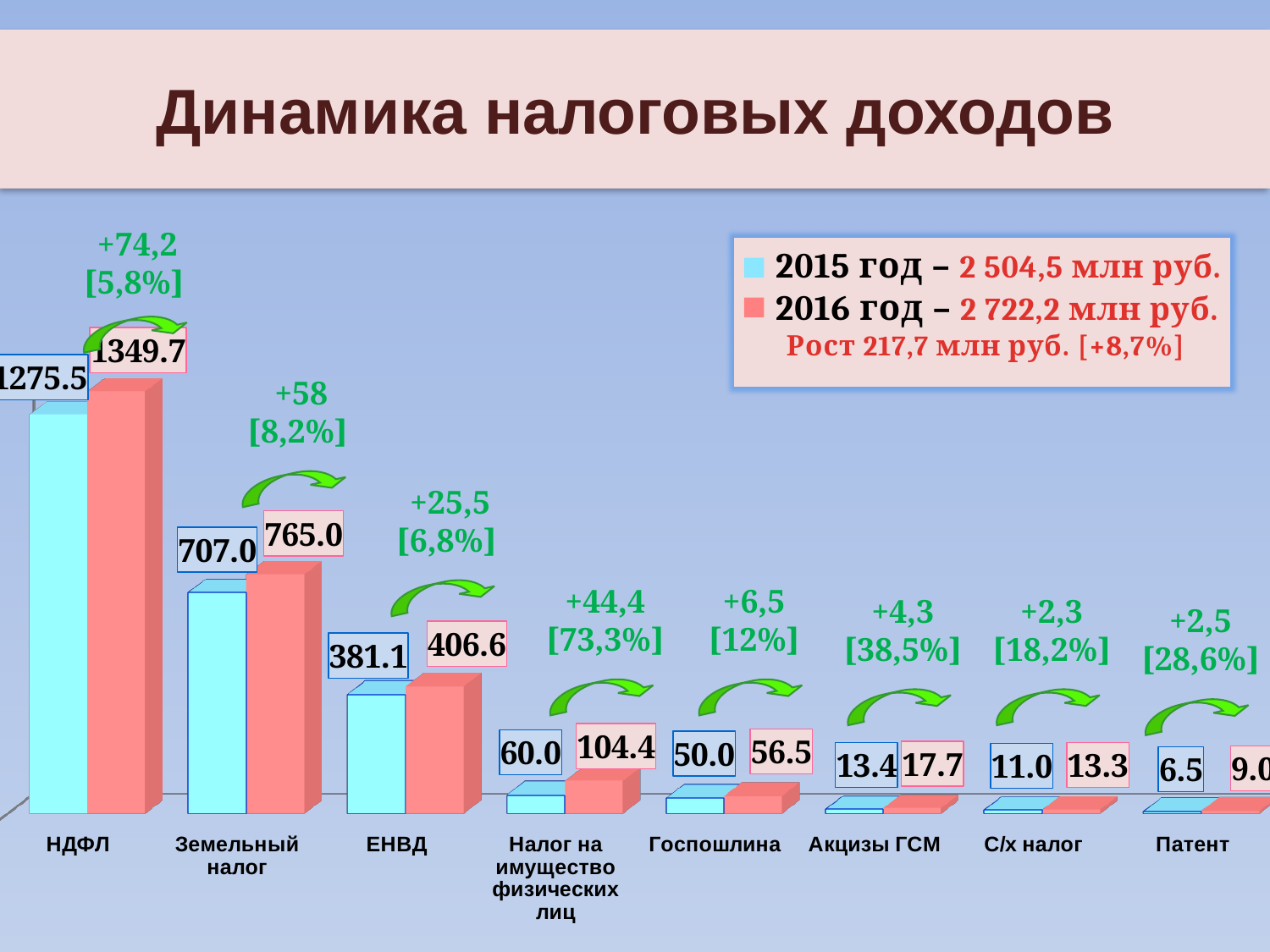
How many series does the legend list? 2 What is the difference between the 2016 and 2015 values for ЕНВД? 25.5 How many tax categories are shown on the x axis? 8 What is the 2015 value for НДФЛ? 1275.5 What is the 2015 value for Акцизы ГСМ? 13.4 What is the 2016 value for Налог на имущество физических лиц? 104.4 Which is larger: the 2015 value for Госпошлина or the 2016 value for Госпошлина? 2016 value for Госпошлина Which category has the lowest 2015 value? Патент Which category has the highest 2016 value? НДФЛ According to the legend, what is the total for 2016 год? 2 722,2 млн руб. What type of chart is shown on the slide? bar chart What is the 2016 value for Земельный налог? 765.0